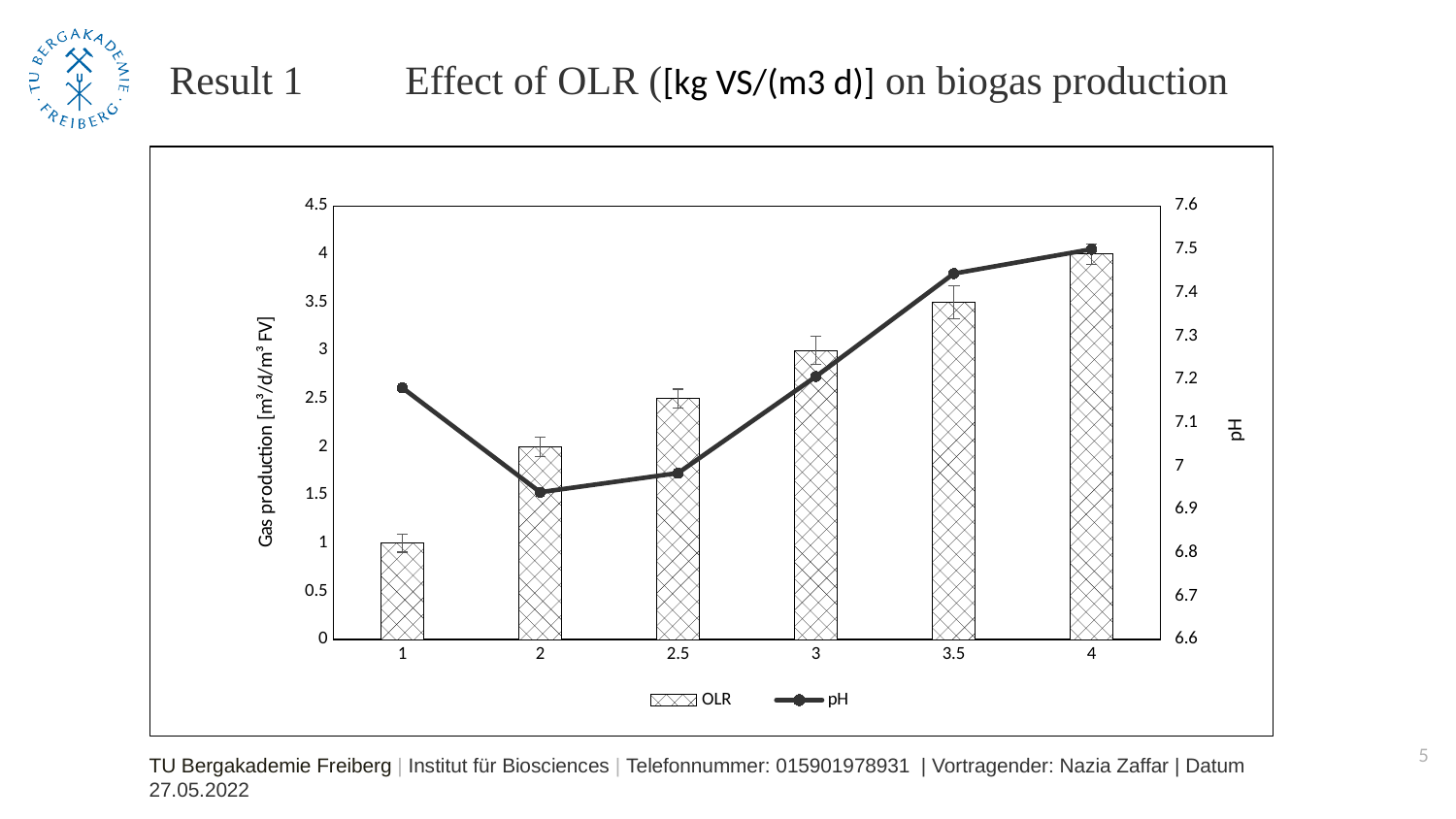
Is the gas production bar for OLR 4 greater or less than 3.5? greater Which OLR category has the lowest gas production bar? 1 Which has the larger gas production bar, OLR 2 or OLR 3.5? 3.5 Is the gas production bar for OLR 1 greater or less than 1.5? less Do the gas production bars rise or fall as OLR increases along the x axis? rise Which OLR category has the highest gas production bar? 4 How many OLR categories are shown on the x axis? 6 What are the two entries in the chart legend? OLR and pH How many series does the legend list? 2 Is the pH value at OLR 3.5 greater or less than 7.3? greater What kind of chart is shown on the slide? Combined bar and line chart